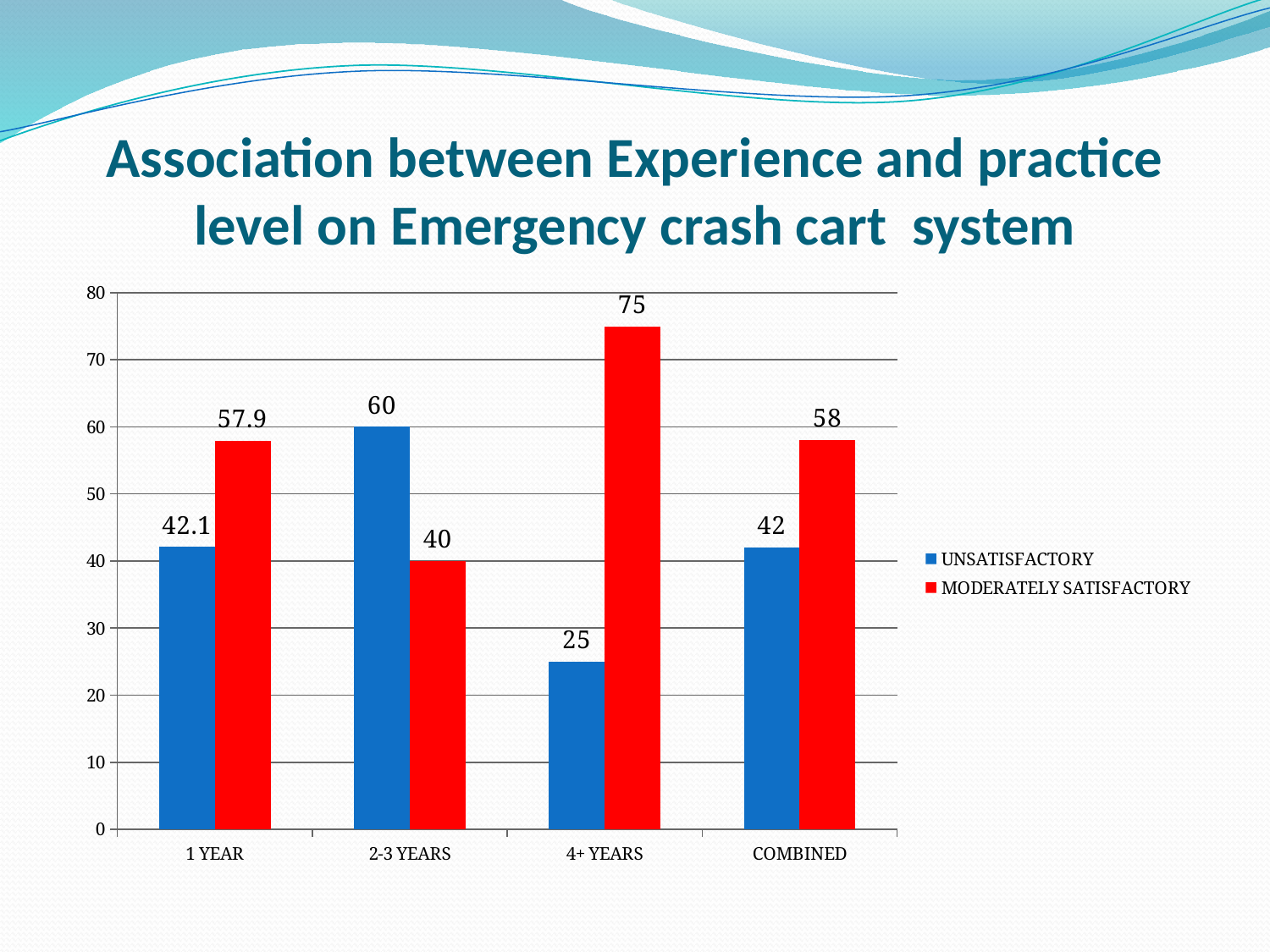
What is the UNSATISFACTORY value for 2-3 YEARS? 60 Which experience category has the lowest UNSATISFACTORY value? 4+ YEARS What is the difference between the MODERATELY SATISFACTORY and UNSATISFACTORY values for 4+ YEARS? 50 What is the MODERATELY SATISFACTORY value for COMBINED? 58 What colour represents the MODERATELY SATISFACTORY series? Red How many experience categories are shown on the x axis? 4 What is the UNSATISFACTORY value for 1 YEAR? 42.1 Which experience category has the highest MODERATELY SATISFACTORY value? 4+ YEARS For 2-3 YEARS, which is larger: UNSATISFACTORY or MODERATELY SATISFACTORY? UNSATISFACTORY How many series does the legend list? 2 What is the MODERATELY SATISFACTORY value for 4+ YEARS? 75 What kind of chart is shown on the slide? Bar chart